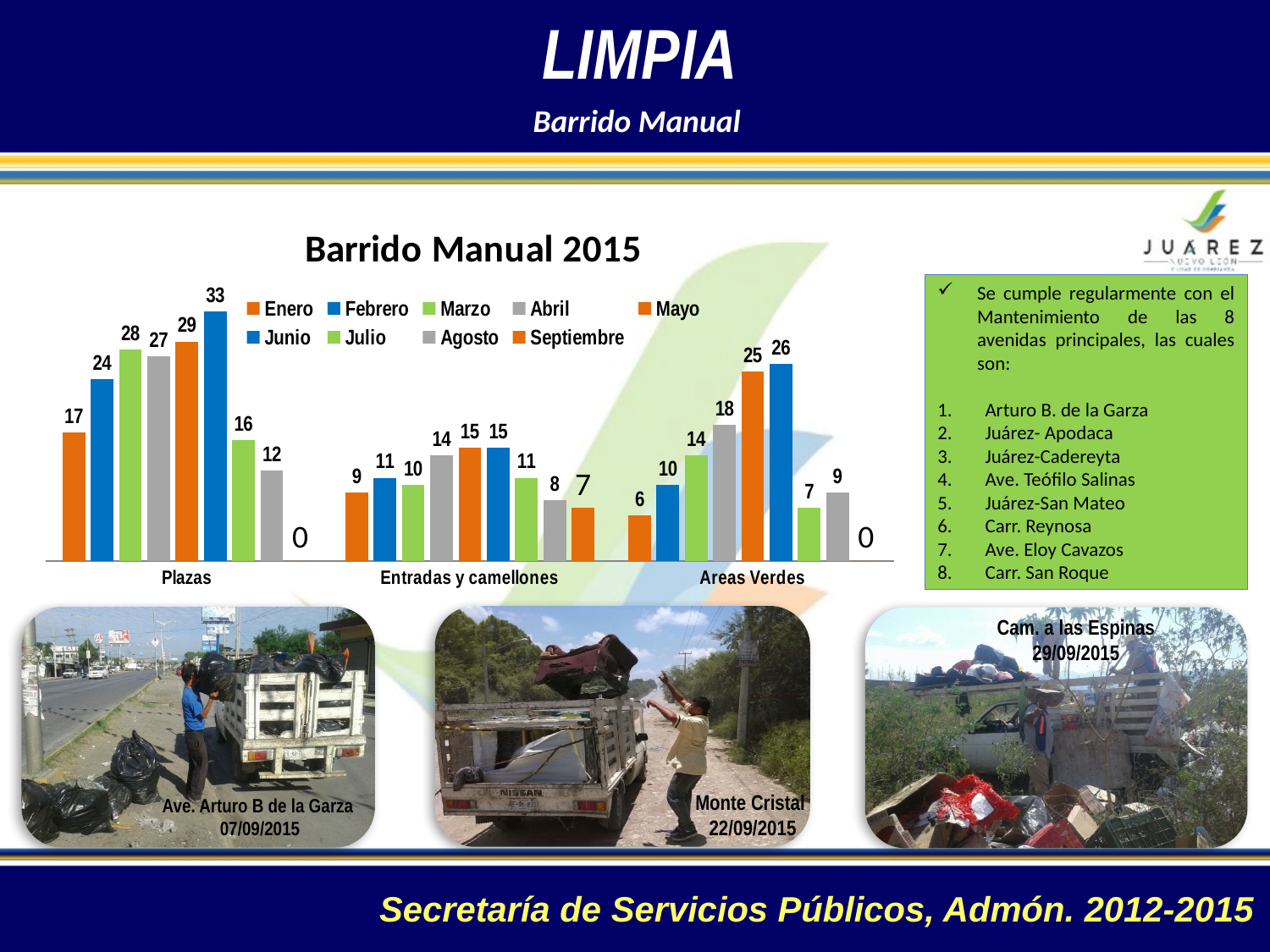
What is the title of the chart? Barrido Manual 2015 How many categories are shown on the x axis of the chart? 3 Which category has the larger Mayo value, Plazas or Areas Verdes? Plazas Which month has the highest value in the Plazas category? Junio Which month has the lowest value in the Entradas y camellones category? Septiembre What type of chart is shown on the slide? Bar chart What is the value for Junio in the Areas Verdes category? 26 How many series does the chart legend list? 9 What is the value for Abril in the Areas Verdes category? 18 What is the value for Septiembre in the Plazas category? 0 What is the difference between the Junio value for Plazas and the Junio value for Areas Verdes? 7 What is the difference between the Enero value for Plazas and the Enero value for Entradas y camellones? 8